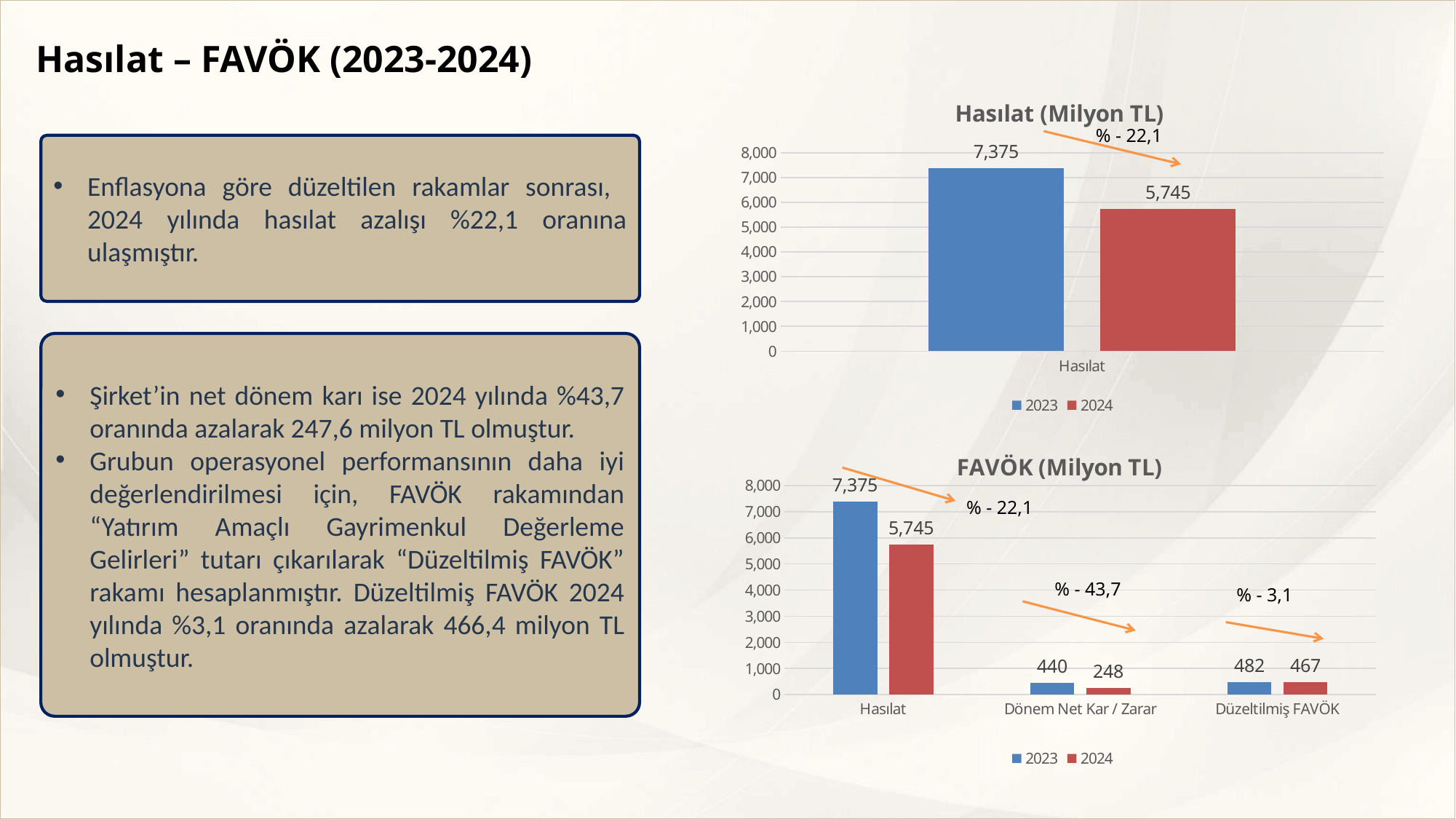
In the 'Hasılat (Milyon TL)' chart, how many series does the legend list? 2 In the 'Hasılat (Milyon TL)' chart, what is the value for 2023? 7,375 In the 'FAVÖK (Milyon TL)' chart, what is the 2023 value for Düzeltilmiş FAVÖK? 482 In the 'Hasılat (Milyon TL)' chart, what is the value for 2024? 5,745 In the 'FAVÖK (Milyon TL)' chart, what is the 2024 value for Dönem Net Kar / Zarar? 248 In the 'FAVÖK (Milyon TL)' chart, which category has the highest 2023 value? Hasılat In the 'Hasılat (Milyon TL)' chart, what is the difference between the 2023 and 2024 values? 1,630 What kind of chart is the 'Hasılat (Milyon TL)' chart? Bar chart In the 'FAVÖK (Milyon TL)' chart, how many categories are shown on the x axis? 3 In the 'FAVÖK (Milyon TL)' chart, which category has the lowest 2024 value? Dönem Net Kar / Zarar In the 'FAVÖK (Milyon TL)' chart, what is the difference between the 2023 and 2024 values for Dönem Net Kar / Zarar? 192 In the 'FAVÖK (Milyon TL)' chart, which is larger: the 2023 value for Dönem Net Kar / Zarar or the 2023 value for Düzeltilmiş FAVÖK? Düzeltilmiş FAVÖK (482)